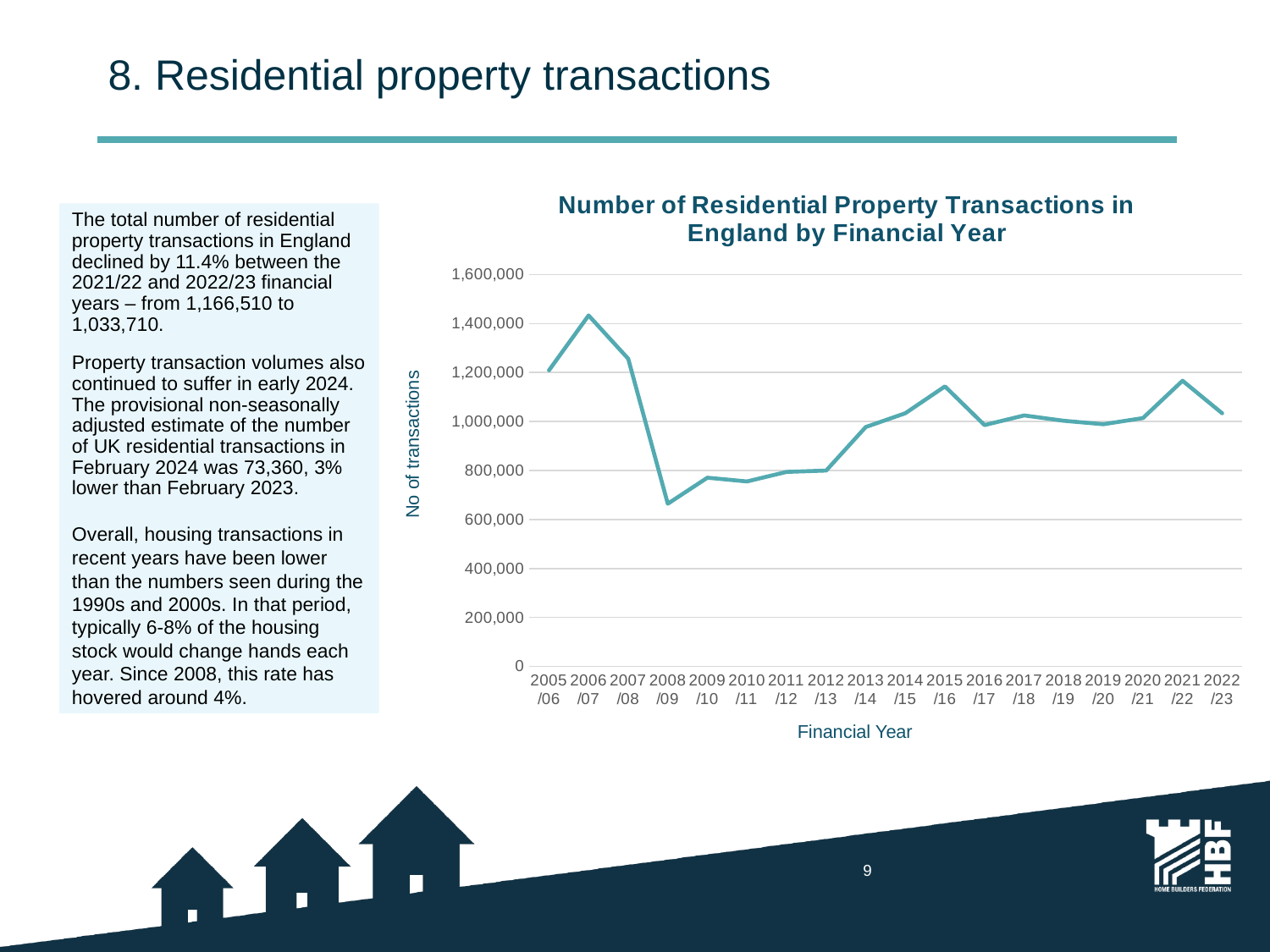
Is the value for 2008/09 greater or less than 800,000? less What is the title of the chart? Number of Residential Property Transactions in England by Financial Year Is the value for 2006/07 greater or less than 1,400,000? greater Is the value for 2015/16 greater or less than 1,000,000? greater What is the label on the vertical axis of the chart? No of transactions Which is larger, the value for 2006/07 or the value for 2021/22? 2006/07 Do the values rise or fall between 2021/22 and 2022/23? fall What kind of chart is shown on the slide? Line chart Which is larger, the value for 2008/09 or the value for 2016/17? 2016/17 Which financial year has the lowest number of transactions? 2008/09 Which financial year has the highest number of transactions? 2006/07 How many financial years are plotted on the chart? 18